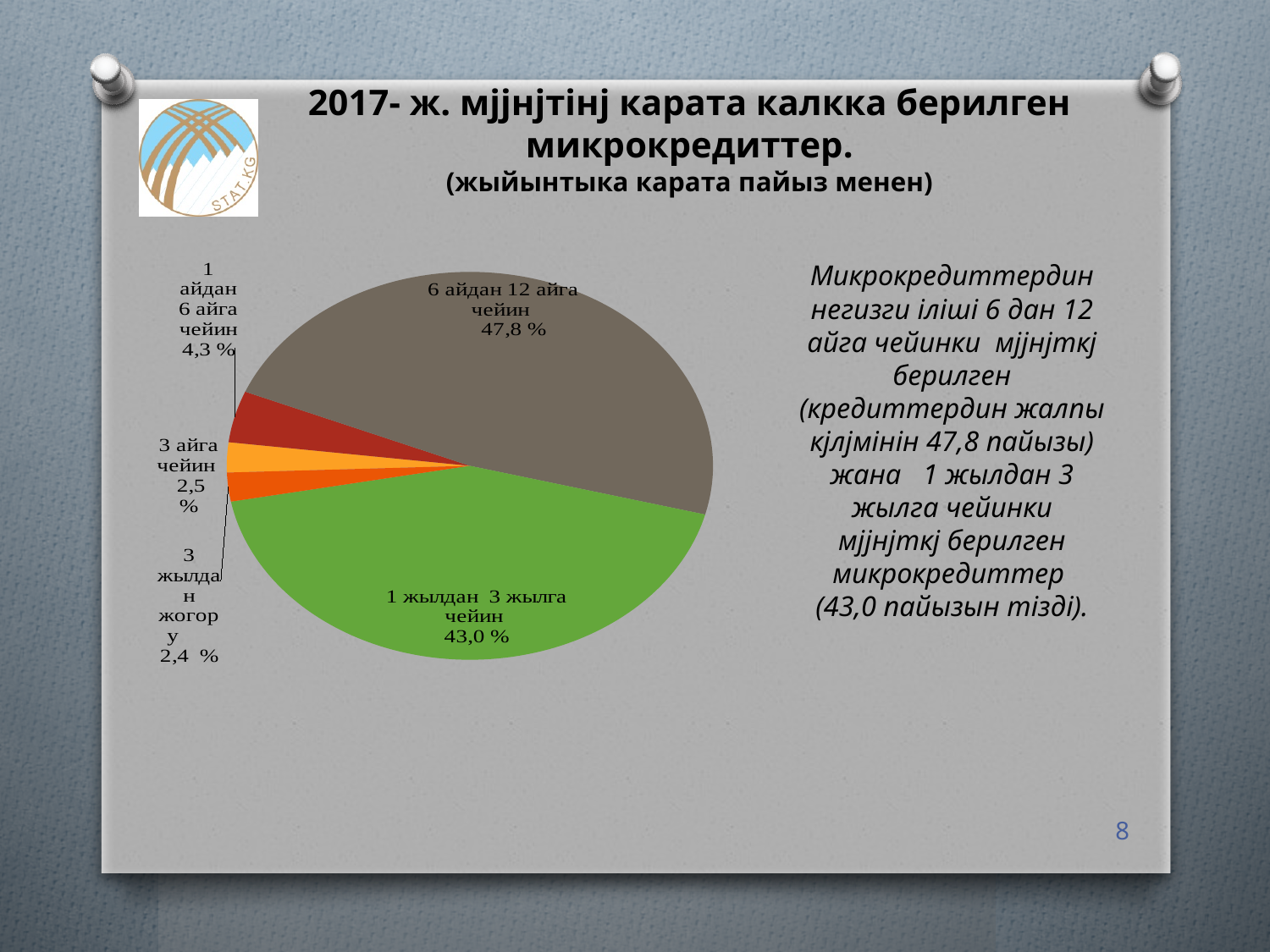
How many slices does the pie chart have? 5 What colour is the slice for "1 жылдан 3 жылга чейин"? green What share of microcredits was issued for the term "1 айдан 6 айга чейин"? 4,3 % Which term category has the largest share of the pie? 6 айдан 12 айга чейин What share of microcredits was issued for the term "1 жылдан 3 жылга чейин"? 43,0 % What share of microcredits was issued for the term "3 айга чейин"? 2,5 % What is the combined share of the "6 айдан 12 айга чейин" and "1 жылдан 3 жылга чейин" slices? 90,8 % Which is larger: the share for "1 айдан 6 айга чейин" or the share for "3 айга чейин"? 1 айдан 6 айга чейин What share of microcredits was issued for the term "3 жылдан жогору"? 2,4 % What share of microcredits was issued for the term "6 айдан 12 айга чейин"? 47,8 % What is the difference in percentage points between the "6 айдан 12 айга чейин" slice and the "1 жылдан 3 жылга чейин" slice? 4,8 What kind of chart is shown on the slide? pie chart